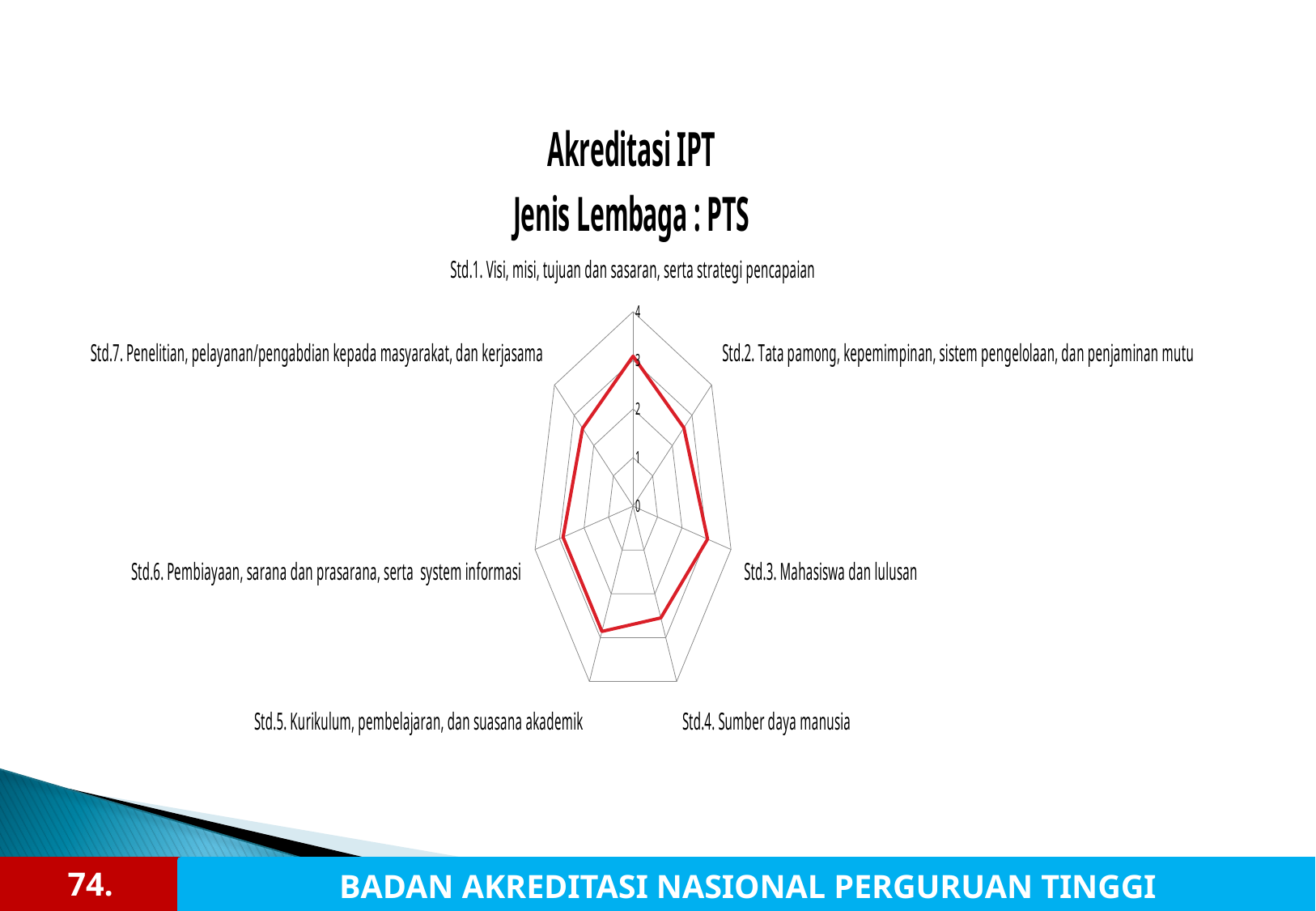
Is the value for Std.4. Sumber daya manusia greater or less than 4? less Is the value for Std.2. Tata pamong, kepemimpinan, sistem pengelolaan, dan penjaminan mutu greater or less than 4? less What is the title of the chart? Akreditasi IPT Jenis Lembaga : PTS What kind of chart is shown on the slide? radar chart Is the value for Std.7. Penelitian, pelayanan/pengabdian kepada masyarakat, dan kerjasama greater or less than 4? less What is the highest value shown on the chart's axis scale? 4 How many standards (categories) are plotted on the radar chart? 7